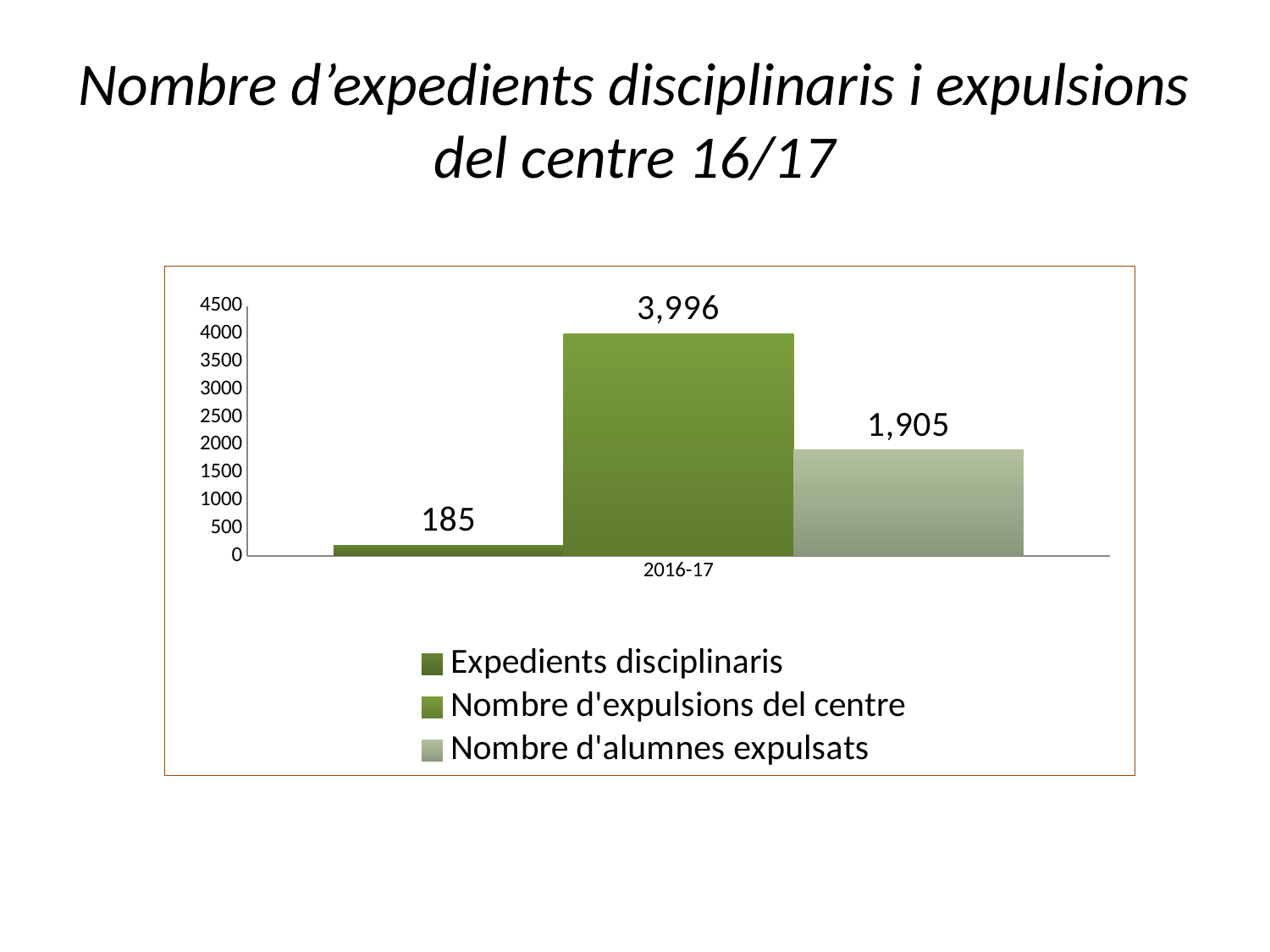
What is the difference between Nombre d'alumnes expulsats and Expedients disciplinaris? 1,720 What is the value for Expedients disciplinaris in 2016-17? 185 What is the value for Nombre d'alumnes expulsats in 2016-17? 1,905 Which is larger, Nombre d'alumnes expulsats or Expedients disciplinaris? Nombre d'alumnes expulsats How many series does the legend list? 3 What category label is shown on the x axis? 2016-17 Which series has the lowest value in 2016-17? Expedients disciplinaris What is the value for Nombre d'expulsions del centre in 2016-17? 3,996 Which series has the highest value in 2016-17? Nombre d'expulsions del centre What kind of chart is shown on the slide? bar chart Is the value for Nombre d'expulsions del centre greater or less than 3500? greater What is the difference between Nombre d'expulsions del centre and Nombre d'alumnes expulsats? 2,091